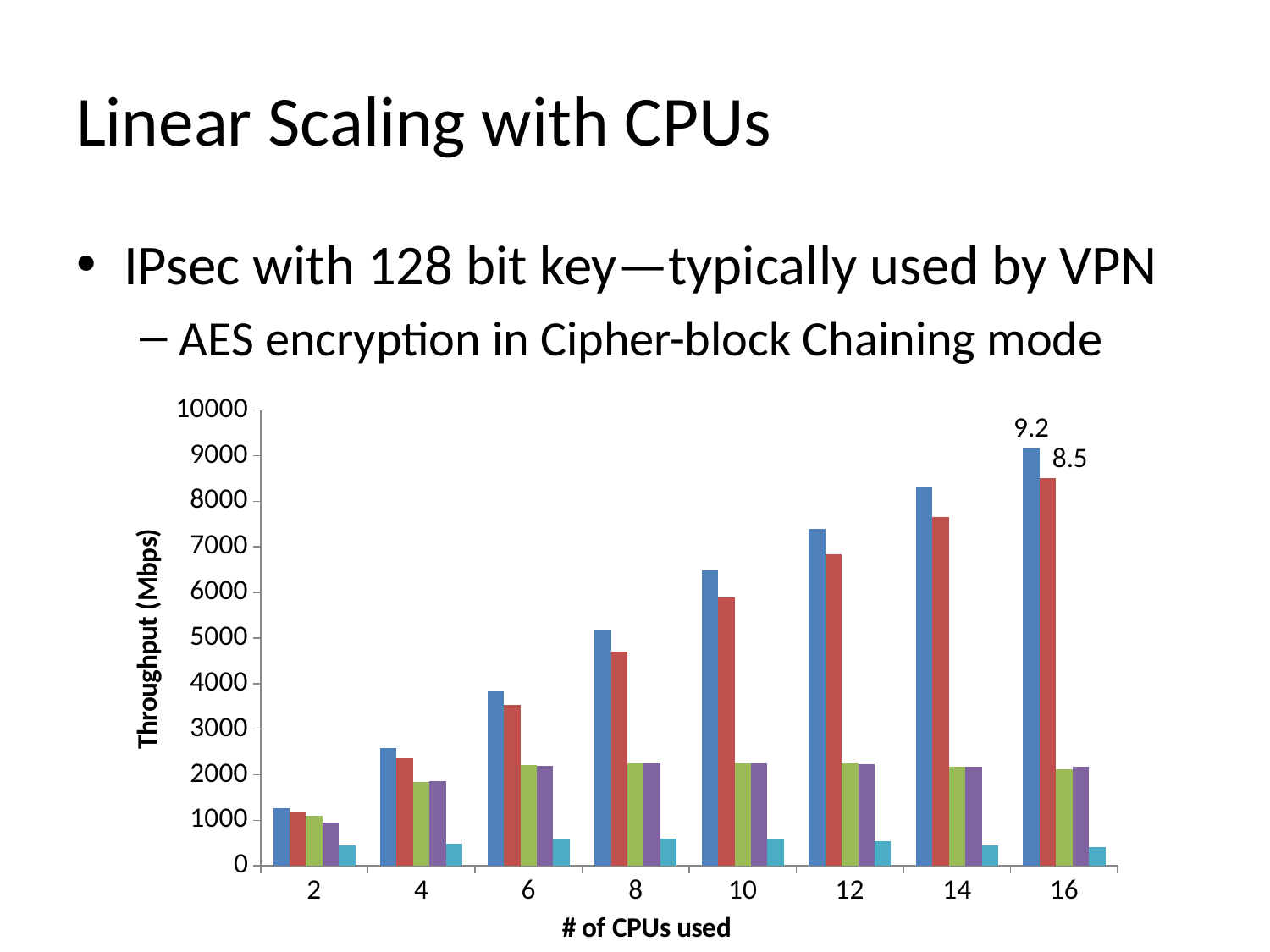
What kind of chart is shown on the slide? bar chart Is the value of the light blue bar at 10 CPUs greater or less than 1000? less Do the blue bars rise or fall as the number of CPUs increases? rise How many CPU-count categories are shown on the x axis? 8 What is the title of the x axis? # of CPUs used Is the value of the blue bar at 16 CPUs greater or less than 9000? greater At which number of CPUs is the blue bar highest? 16 What data label is printed above the blue bar at 16 CPUs? 9.2 What data label is printed above the red bar at 16 CPUs? 8.5 Is the value of the red bar at 8 CPUs greater or less than 5000? less At which number of CPUs is the blue bar lowest? 2 What is the title of the y axis? Throughput (Mbps)